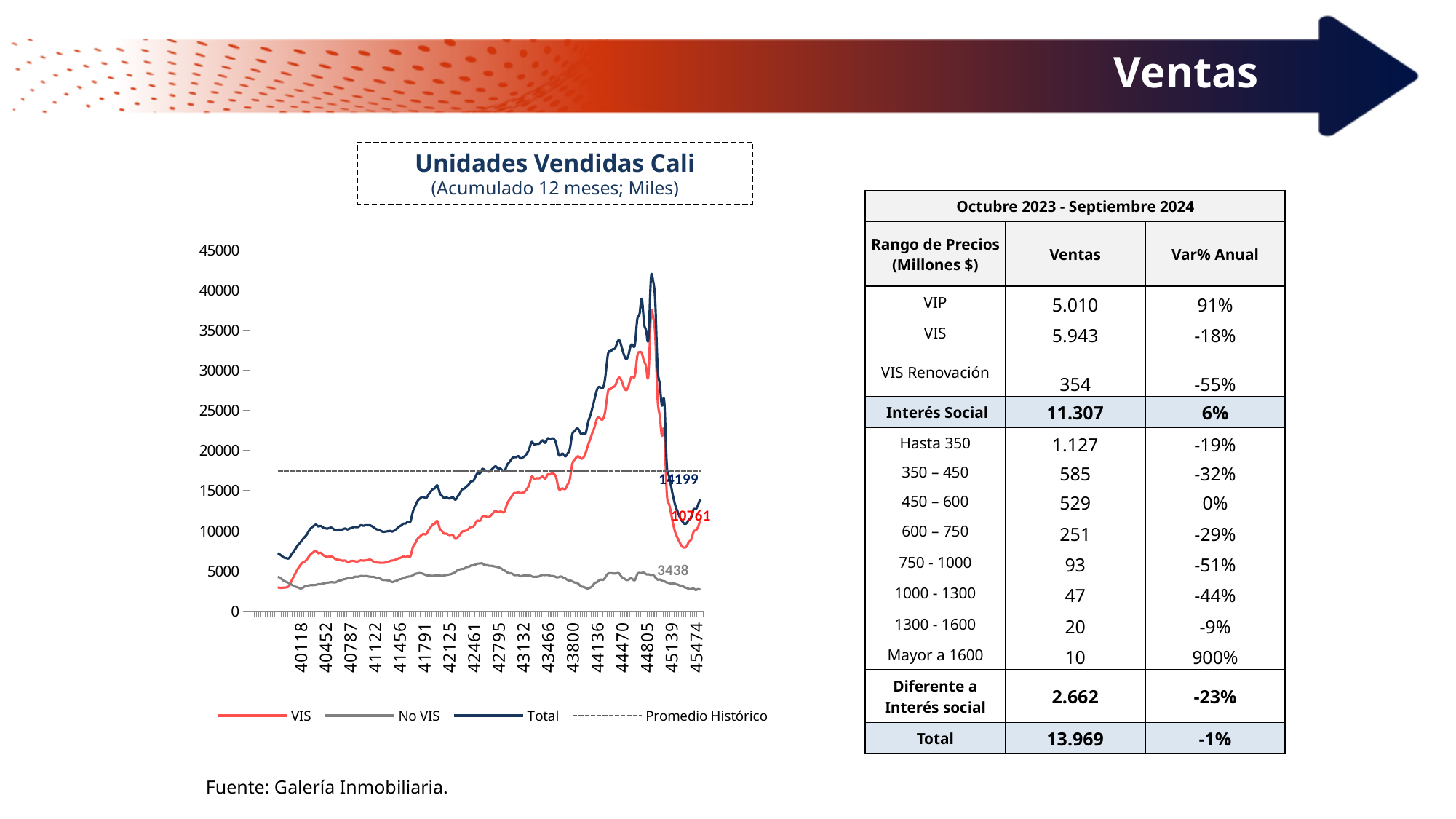
Which series has the lowest labelled end value? No VIS What kind of chart is shown on the slide? line chart Is the peak value of the Total line greater or less than 40000? greater At the end of the series, which is larger: the VIS value or the No VIS value? VIS What is the latest labelled value of the VIS series? 10761 What is the title of the chart? Unidades Vendidas Cali What is the latest labelled value of the Total series? 14199 How many series does the chart legend list? 4 Between the x-axis ticks 44805 and 45139, does the Total line rise or fall? fall What is the latest labelled value of the No VIS series? 3438 Is the Promedio Histórico dashed line greater or less than 20000? less What is the difference between the labelled end values of Total (14199) and VIS (10761)? 3438